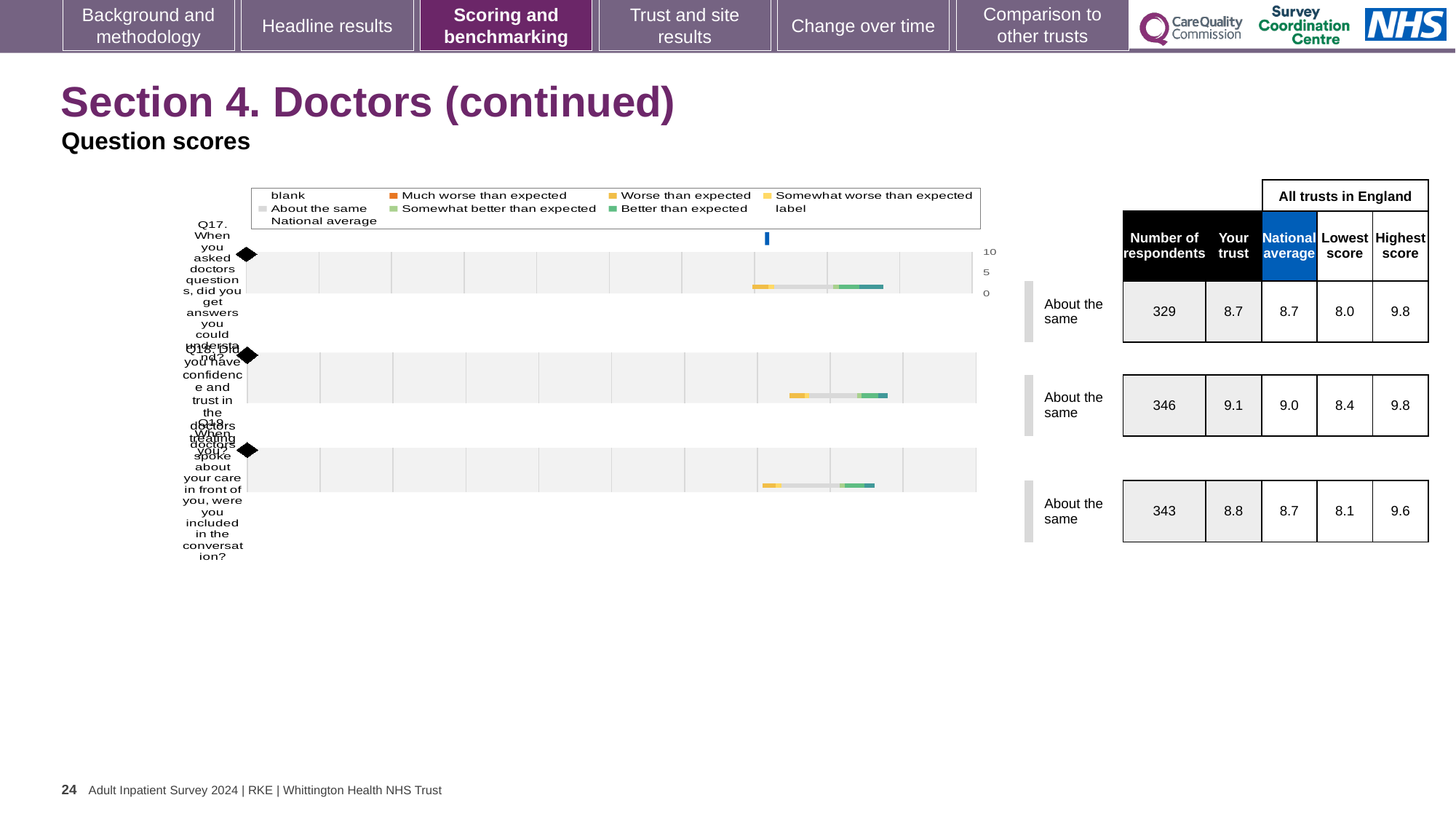
In the table beside the chart, what is the highest score among all trusts in England for Q19? 9.6 Which has the higher 'Your trust' score, Q18 or Q19? Q18 In the table beside the chart, how many respondents answered Q19? 343 What kind of chart is used to show the question scores for Q17, Q18 and Q19? bar chart What benchmarking rating is shown for Q17 (When you asked doctors questions, did you get answers you could understand?)? About the same What is the difference between the 'Your trust' score and the national average for Q18? 0.1 Is the 'Your trust' score for Q17 greater or less than 5 on the chart's axis? greater In the table beside the chart, what is the 'Your trust' score for Q18? 9.1 How many questions are plotted in the chart? 3 Which of the three questions has the highest 'Your trust' score? Q18 In the table beside the chart, what is the national average for Q17? 8.7 What benchmarking rating is shown for Q18 (Did you have confidence and trust in the doctors treating you?)? About the same